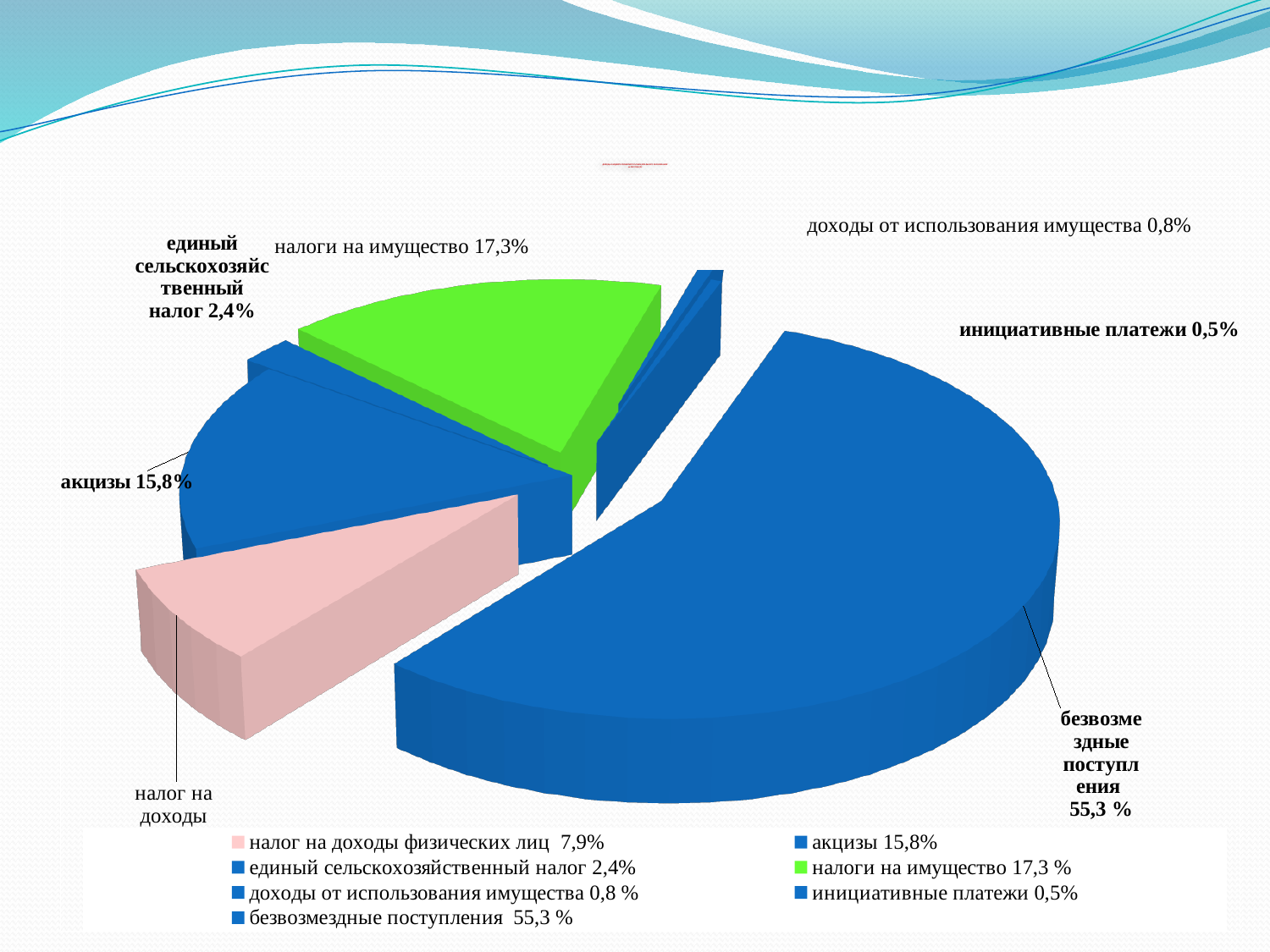
Which category has the smallest share of the pie? инициативные платежи What is the value for налоги на имущество? 17,3% Which category has the largest share of the pie? безвозмездные поступления How many categories does the pie chart show? 7 What is the difference in percentage points between налоги на имущество (17,3%) and акцизы (15,8%)? 1,5 What is the share for безвозмездные поступления? 55,3 % Which is larger, налоги на имущество or акцизы? налоги на имущество What is the value for единый сельскохозяйственный налог? 2,4% What colour is the slice for налоги на имущество? green What kind of chart is shown on the slide? pie chart What is the value for акцизы? 15,8% What is the value for налог на доходы физических лиц? 7,9%